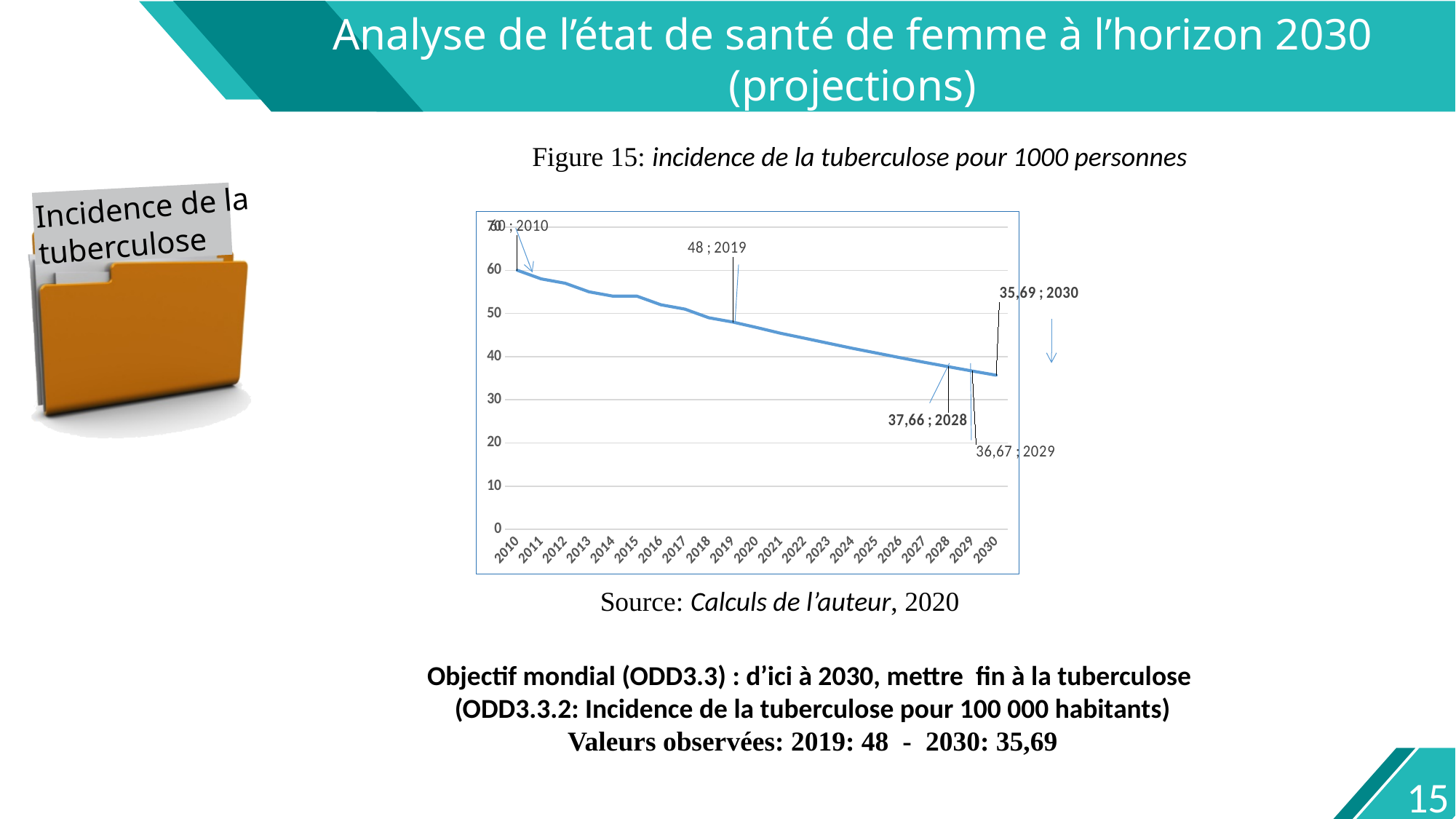
What is the value plotted for 2028? 37,66 What is the value plotted for 2030? 35,69 What is the difference between the values for 2019 and 2030? 12,31 Is the value for 2010 greater or less than 50? greater Do the values rise or fall from 2010 to 2030? fall What is the difference between the values for 2028 and 2029? 0,99 Which year has the lowest value? 2030 What kind of chart is shown? line chart What is the value plotted for 2029? 36,67 How many years are shown on the x axis? 21 What is the value plotted for 2019? 48 Which year has the larger value, 2019 or 2030? 2019